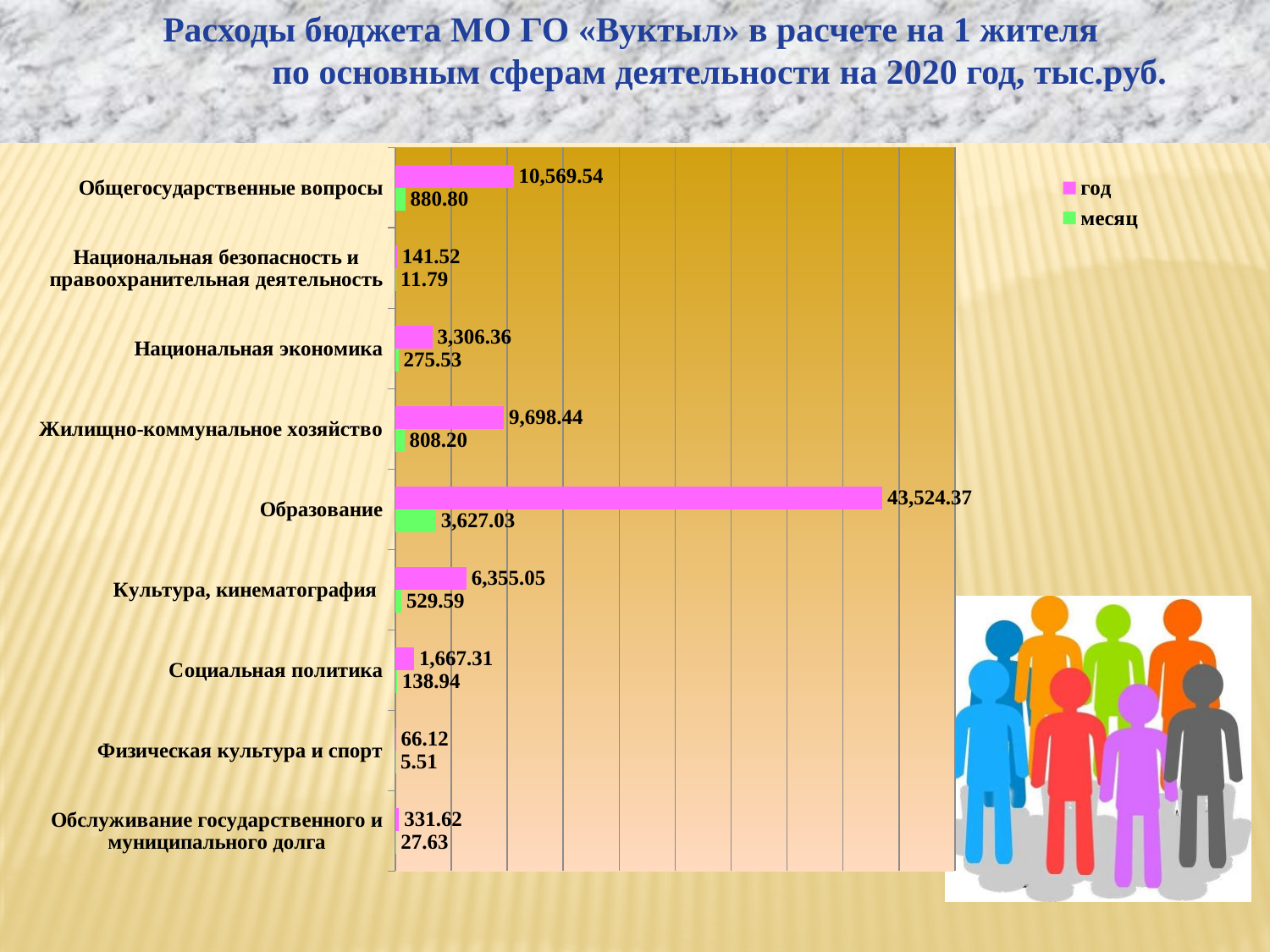
How many categories are shown on the chart? 9 What is the value of the "месяц" series for Жилищно-коммунальное хозяйство? 808.20 What kind of chart is shown on the slide? Bar chart What is the value of the "год" series for Образование? 43,524.37 Which colour represents the "месяц" series in the legend? Green Which category has the highest value in the "год" series? Образование What is the value of the "месяц" series for Физическая культура и спорт? 5.51 What is the value of the "год" series for Культура, кинематография? 6,355.05 Which category has the lowest value in the "месяц" series? Физическая культура и спорт What is the difference between the "год" values for Общегосударственные вопросы and Жилищно-коммунальное хозяйство? 871.10 Which is larger in the "год" series: Национальная экономика or Социальная политика? Национальная экономика How many series does the legend list? 2